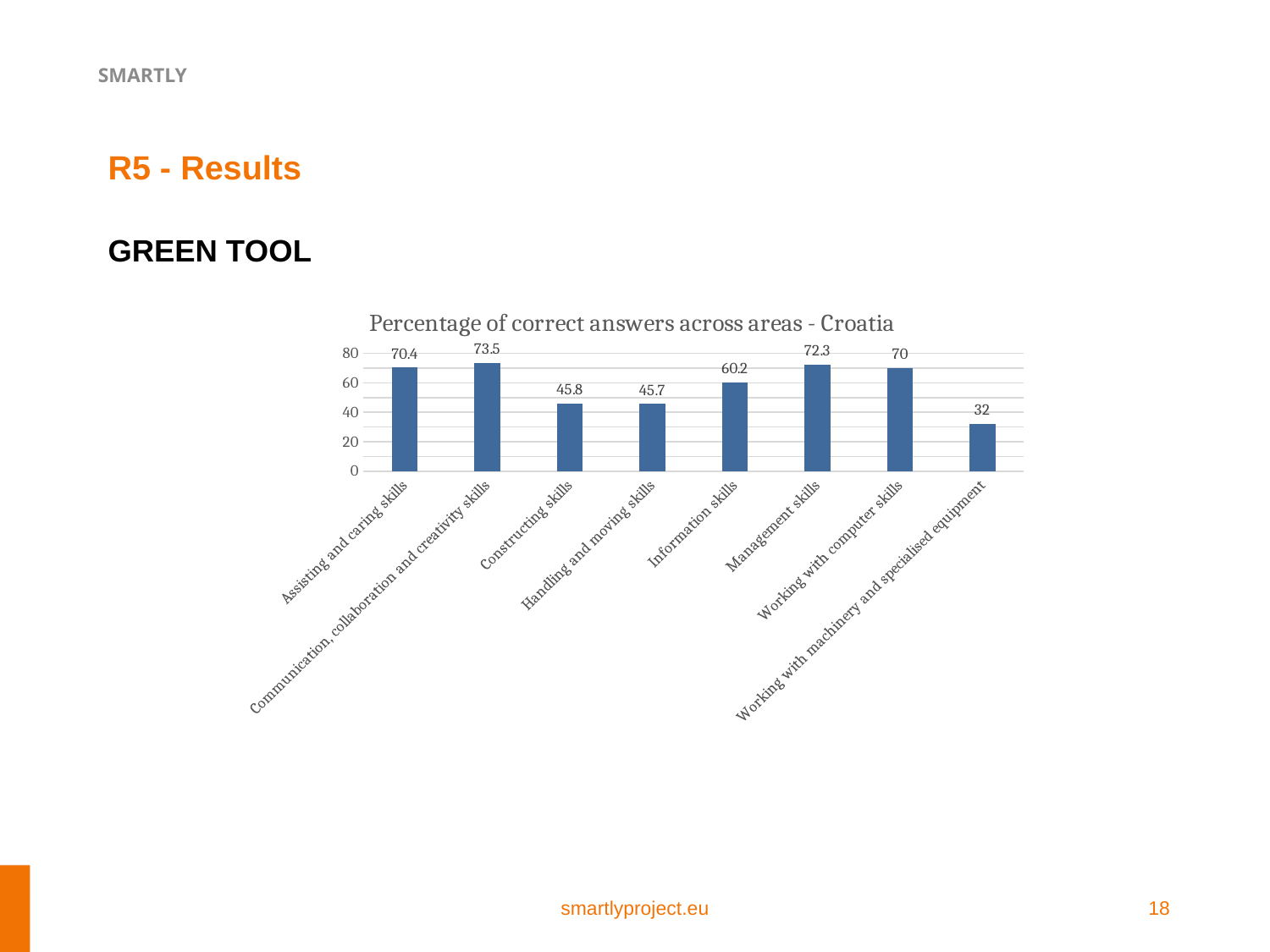
Which area has the lowest percentage of correct answers? Working with machinery and specialised equipment What is the value for Management skills? 72.3 What is the percentage of correct answers for Information skills? 60.2 Is the value for Constructing skills greater or less than 60? less Which area has the highest percentage of correct answers? Communication, collaboration and creativity skills What is the percentage of correct answers for Working with machinery and specialised equipment? 32 Which is larger, the value for Management skills or the value for Working with computer skills? Management skills What is the title of the chart? Percentage of correct answers across areas - Croatia What is the difference between the values for Assisting and caring skills and Information skills? 10.2 What is the difference between the values for Communication, collaboration and creativity skills and Working with machinery and specialised equipment? 41.5 How many areas are shown in the chart? 8 What kind of chart is shown on the slide? bar chart